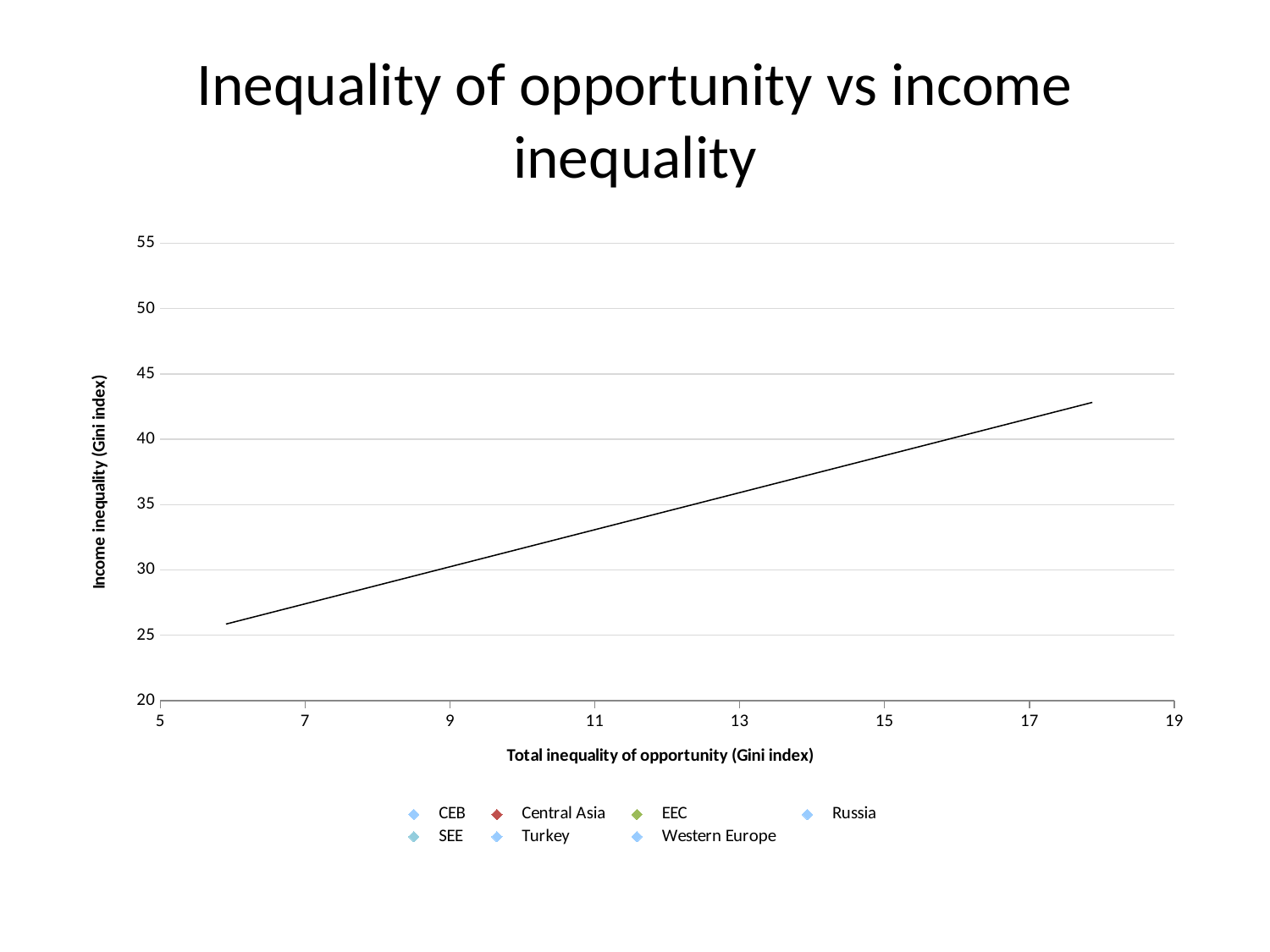
What kind of chart is shown on the slide? scatter chart At a total inequality of opportunity of 7, is the trend line's income inequality value greater or less than 30? less What is the label of the x axis? Total inequality of opportunity (Gini index) At a total inequality of opportunity of 17, is the trend line's income inequality value greater or less than 40? greater What is the title of the chart? Inequality of opportunity vs income inequality At a total inequality of opportunity of 11, is the trend line's income inequality value greater or less than 35? less Does the trend line rise or fall as total inequality of opportunity increases along the x axis? rises How many series does the legend list? 7